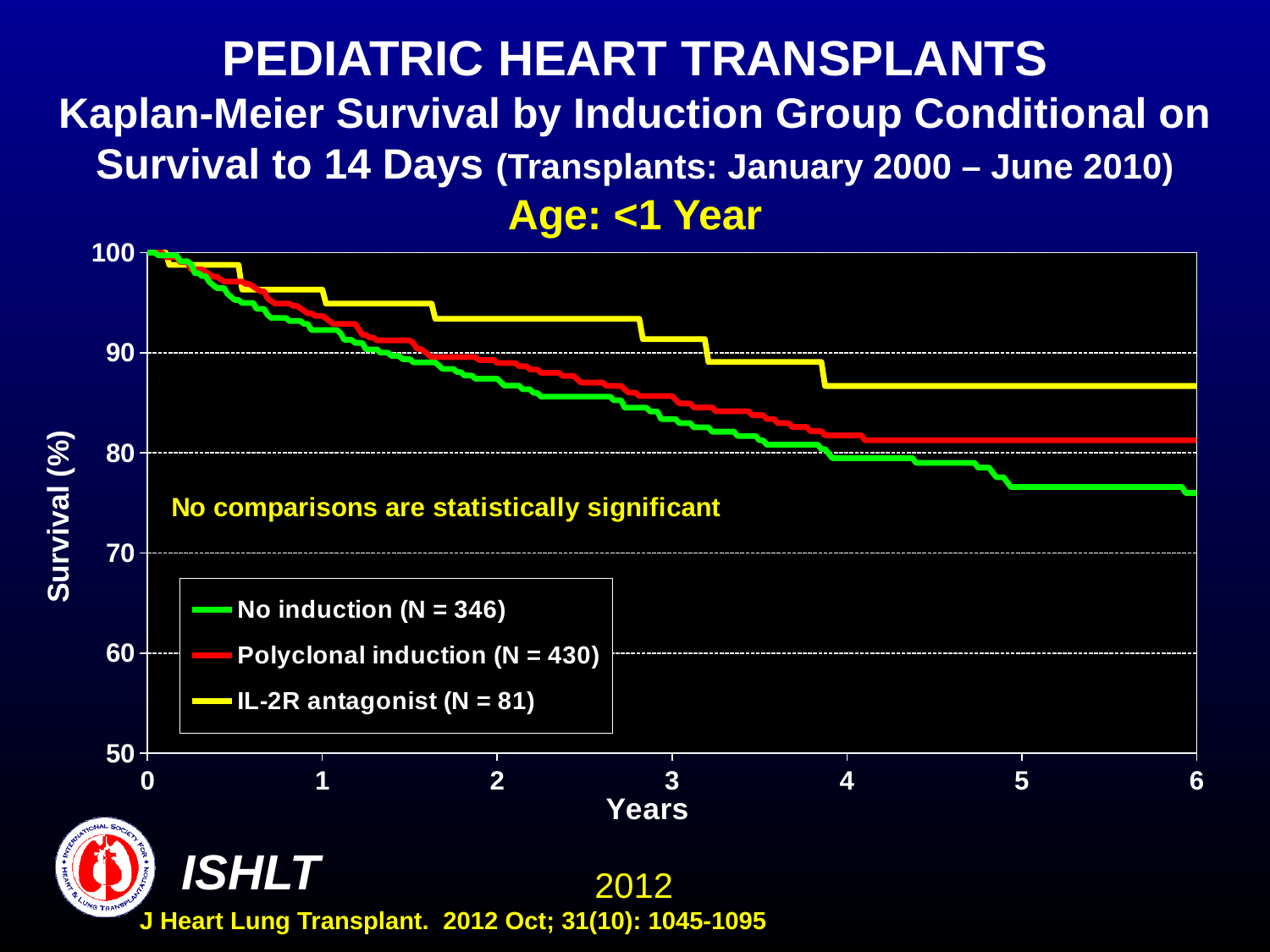
What kind of chart is shown on the slide? line chart Do the survival curves rise or fall as years increase? fall Which induction group has the lowest survival at 6 years? No induction Is the survival value for IL-2R antagonist at 6 years greater or less than 80? greater Is the survival value for IL-2R antagonist at 2 years greater or less than 90? greater Is the survival value for No induction at 6 years greater or less than 80? less What is the N for the No induction group shown in the legend? 346 At 6 years, which has higher survival: No induction or IL-2R antagonist? IL-2R antagonist How many series does the legend list? 3 Which induction group has the highest survival at 6 years? IL-2R antagonist What is the N for the IL-2R antagonist group shown in the legend? 81